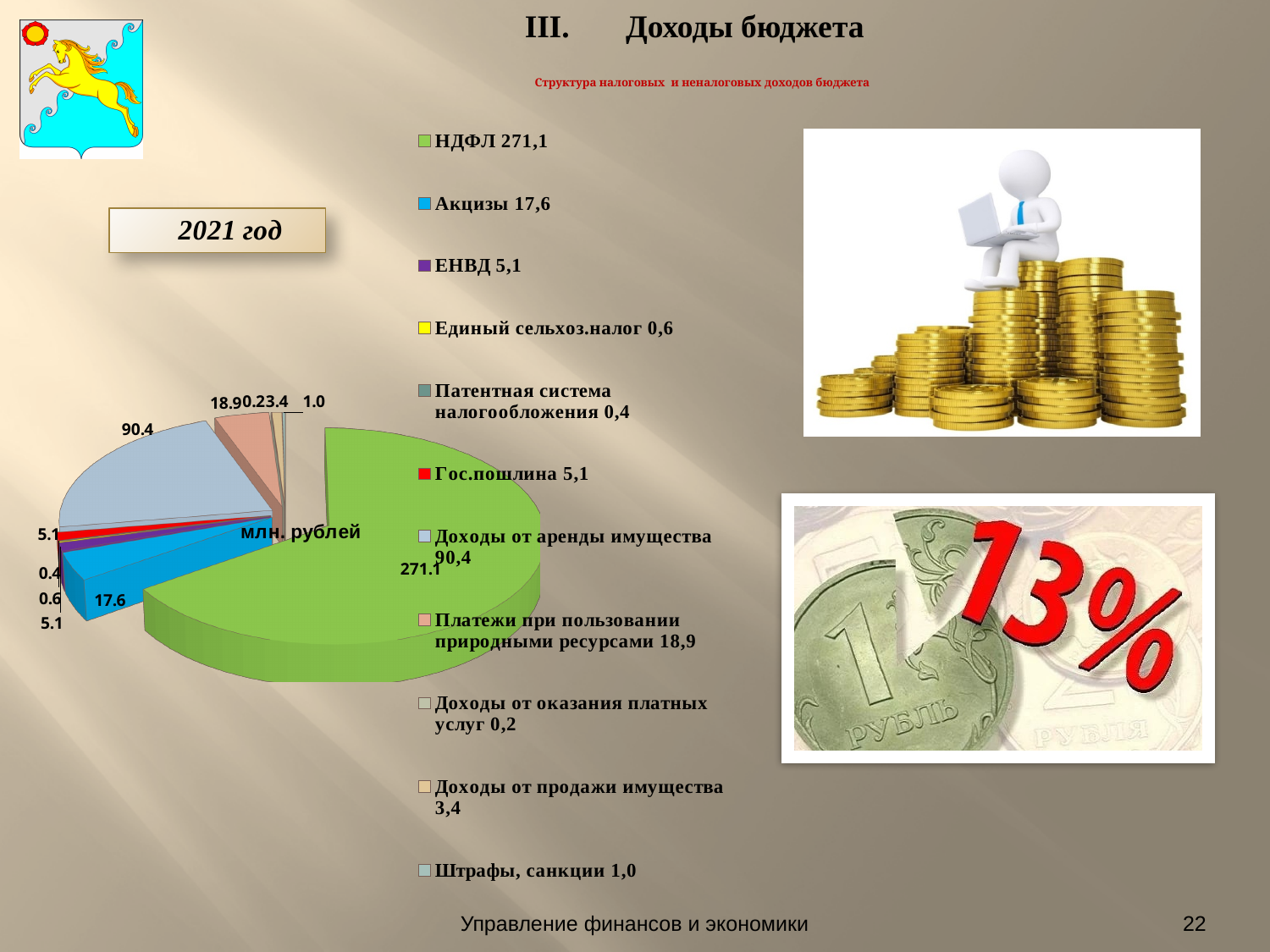
Which category has the largest slice of the pie? НДФЛ What kind of chart is shown on the slide? pie chart What is the difference between the values for НДФЛ and Доходы от аренды имущества? 180,7 How many categories does the legend of the pie chart list? 11 What is the title of the chart on the slide? Структура налоговых и неналоговых доходов бюджета What unit of measurement is shown on the pie chart? млн. рублей What is the value for Платежи при пользовании природными ресурсами? 18,9 What is the value for Доходы от аренды имущества? 90,4 Which category has the smallest value in the pie chart? Доходы от оказания платных услуг What is the value for Акцизы? 17,6 Which is larger: Платежи при пользовании природными ресурсами or Акцизы? Платежи при пользовании природными ресурсами What is the value for НДФЛ in the pie chart? 271,1